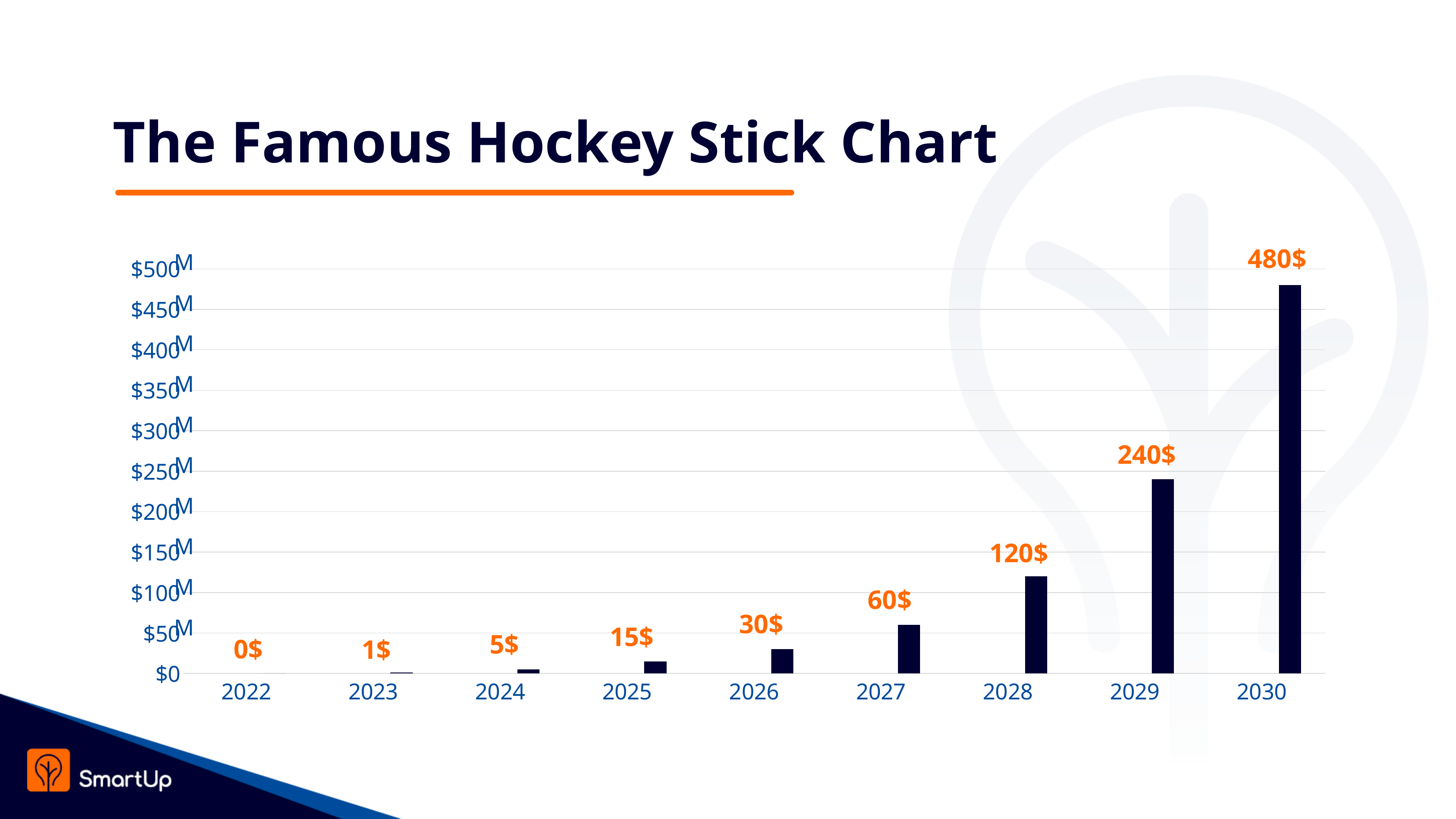
Which year has the lowest value? 2022 Is the value for 2029 greater or less than $200M? greater What is the difference between the values for 2030 and 2029? 240$ What kind of chart is shown on the slide? bar chart Which is larger, the value for 2025 or the value for 2026? 2026 What is the difference between the values for 2028 and 2026? 90$ What is the value shown for 2030? 480$ What is the value shown for 2024? 5$ Which year has the highest value? 2030 How many years are shown on the x axis? 9 Do the values rise or fall from 2022 to 2030? rise What is the value shown for 2027? 60$